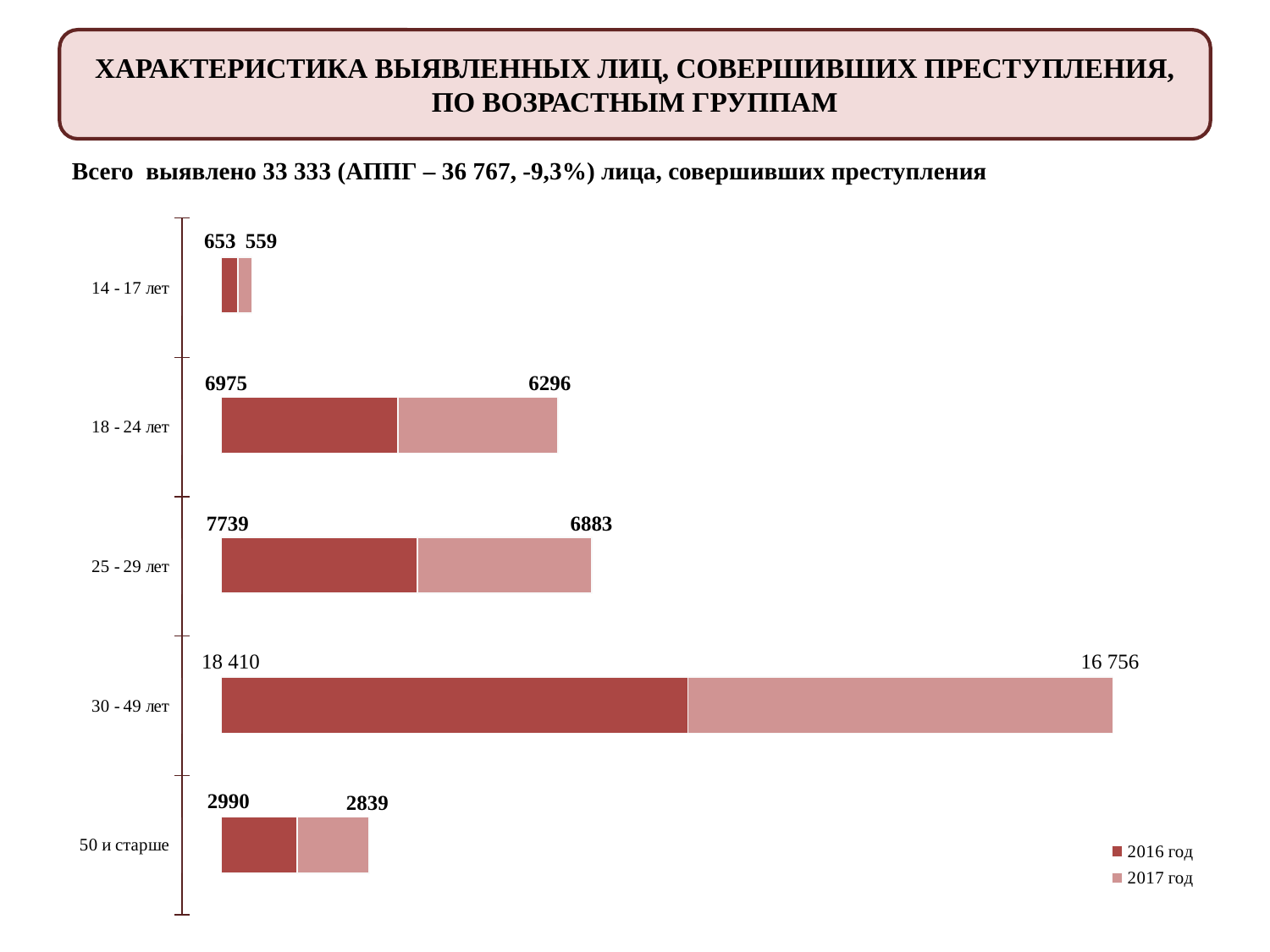
What is the value for 2016 год in the 30 - 49 лет age group? 18 410 What is the value for 2016 год in the 50 и старше age group? 2990 Which age group has the lowest value for 2017 год? 14 - 17 лет How many age groups are shown in the chart? 5 What is the total of the stacked bar for the 50 и старше age group? 5829 What is the value for 2017 год in the 18 - 24 лет age group? 6296 What is the difference between the 2016 год and 2017 год values for the 25 - 29 лет age group? 856 What kind of chart is shown on the slide? Bar chart Which is larger for the 18 - 24 лет age group: the 2016 год value or the 2017 год value? 2016 год Which age group has the highest value for 2016 год? 30 - 49 лет How many series does the legend list? 2 What is the value for 2017 год in the 14 - 17 лет age group? 559